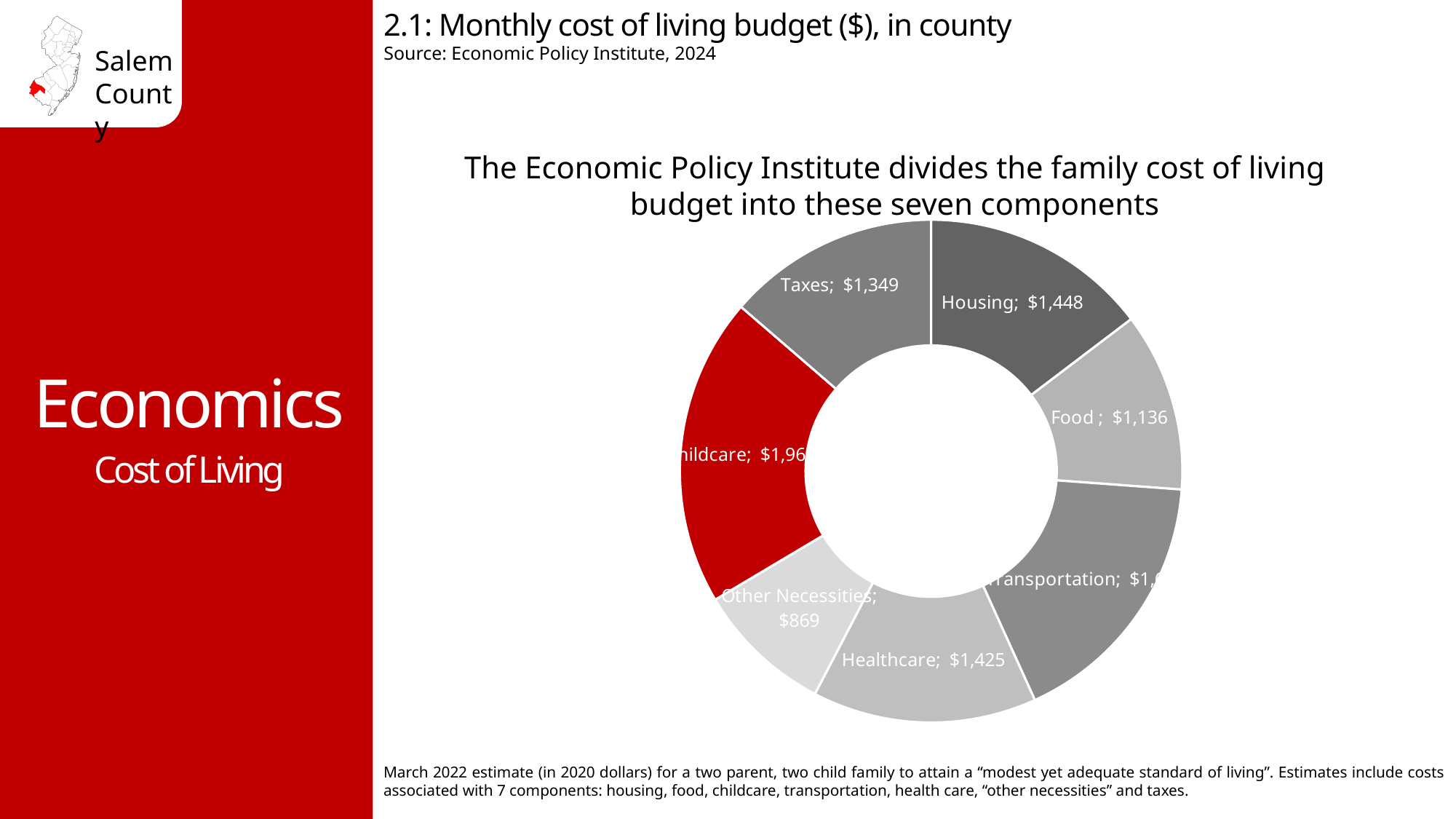
What kind of chart is shown on the slide? Doughnut (pie) chart What is the monthly cost for Food? $1,136 Which component has the smallest monthly cost? Other Necessities Which is larger, the monthly cost for Healthcare or for Food? Healthcare What is the monthly cost for Other Necessities? $869 What colour is the Childcare slice in the chart? Red What is the difference between the Housing and Taxes monthly costs? $99 How many components (slices) does the chart show? 7 What is the monthly cost for Taxes? $1,349 What is the monthly cost for Healthcare? $1,425 Which component has the largest monthly cost? Childcare What is the monthly cost for Housing? $1,448